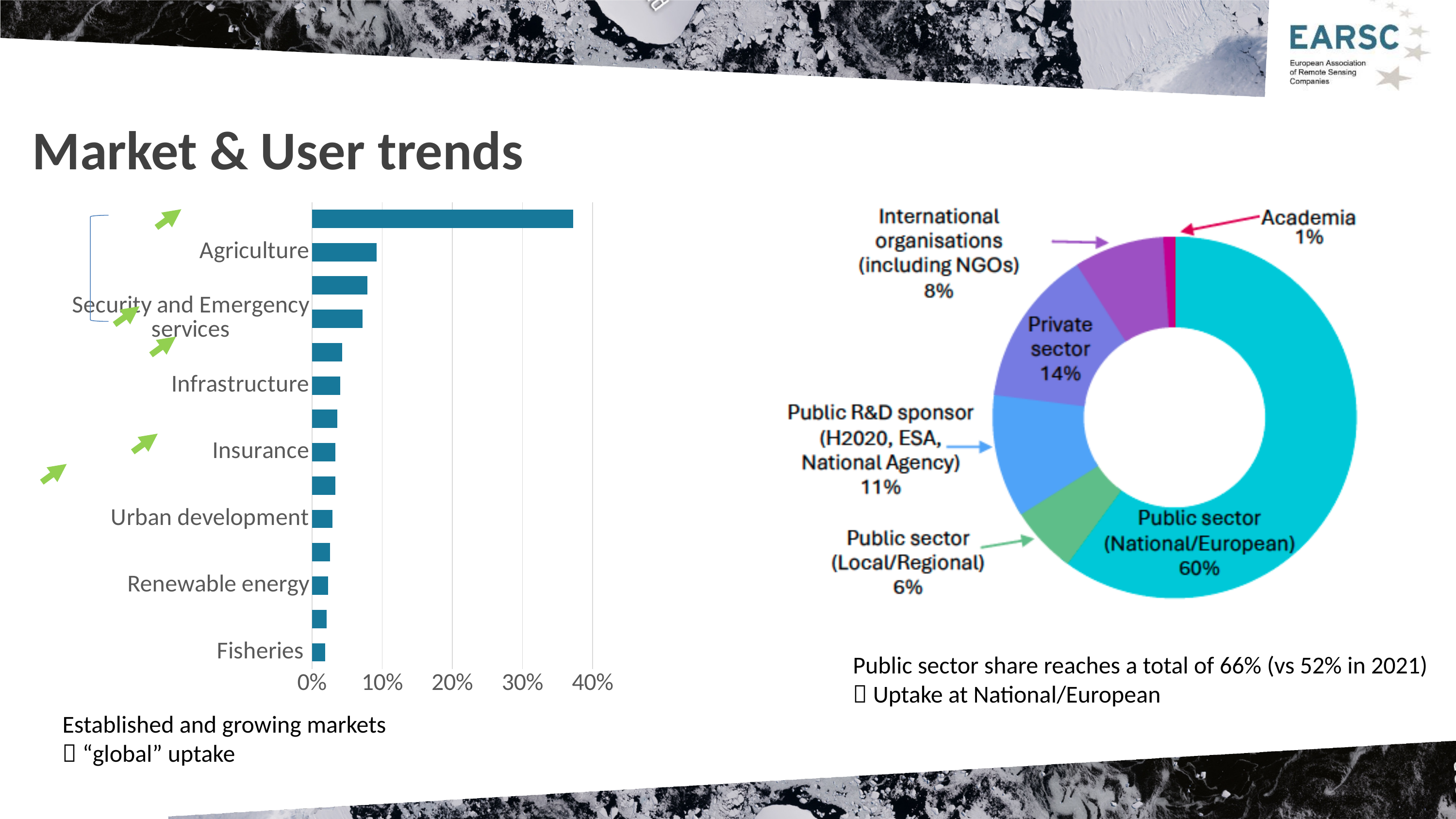
In the pie chart on the right, what share does Public R&D sponsor (H2020, ESA, National Agency) have? 11% In the pie chart on the right, what is the difference between the Private sector share and the International organisations (including NGOs) share? 6% In the pie chart on the right, which is larger: Public sector (Local/Regional) or International organisations (including NGOs)? International organisations (including NGOs) In the bar chart on the left, which is larger: Agriculture or Fisheries? Agriculture In the pie chart on the right, what share does Private sector have? 14% How many slices does the pie chart on the right have? 6 In the bar chart on the left, is the value for Agriculture greater or less than 10%? less What kind of chart is shown on the left of the slide? Bar chart In the pie chart on the right, what share does Public sector (National/European) have? 60% In the pie chart on the right, which category has the smallest share? Academia In the bar chart on the left, is the longest bar greater or less than 30%? greater In the pie chart on the right, which category has the largest share? Public sector (National/European)